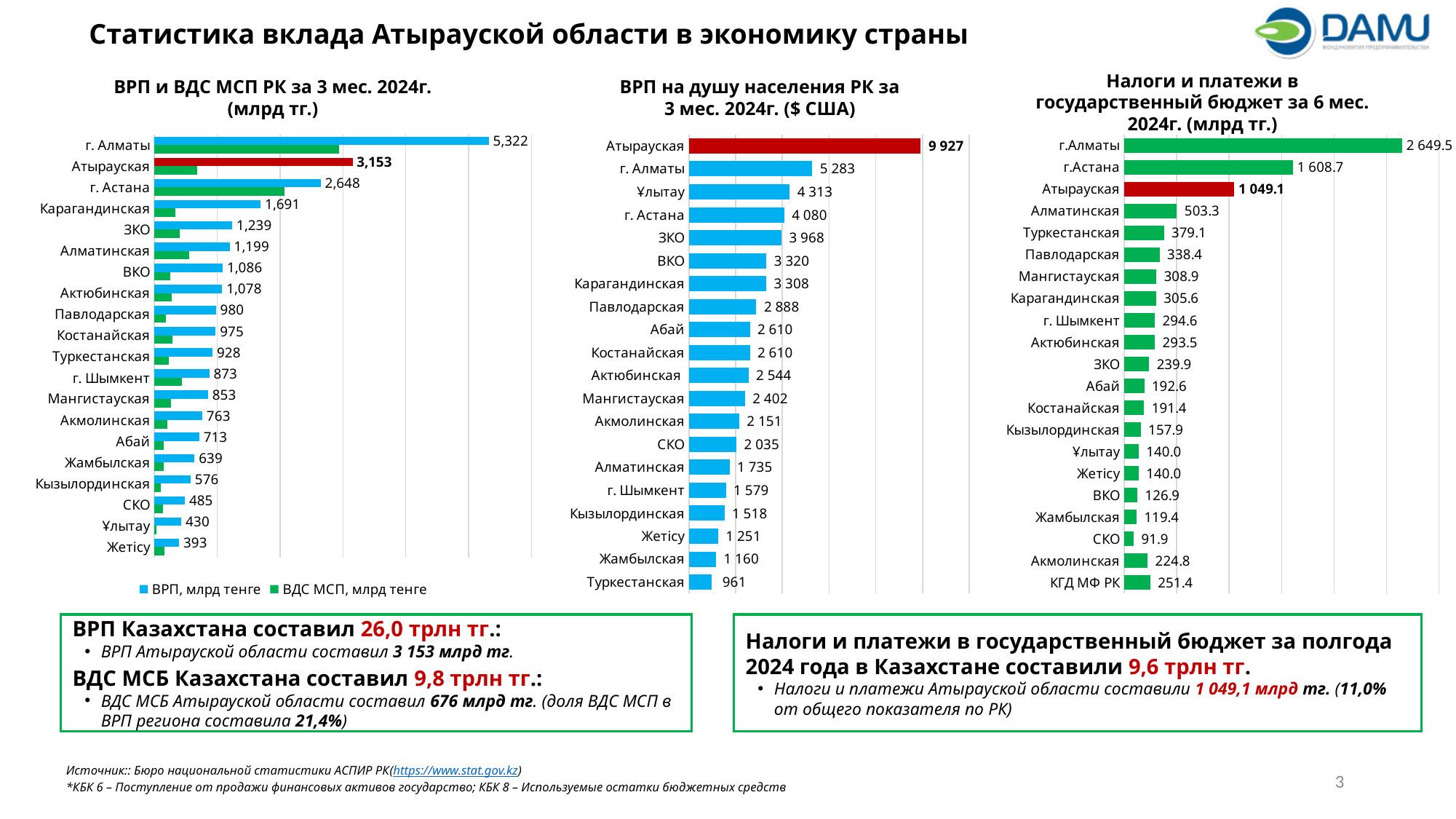
In the chart 'ВРП на душу населения РК за 3 мес. 2024г. ($ США)', what is the value for Ұлытау? 4 313 In the chart 'ВРП на душу населения РК за 3 мес. 2024г. ($ США)', how much higher is Атырауская than г. Алматы? 4 644 In the chart 'ВРП и ВДС МСП РК за 3 мес. 2024г. (млрд тг.)', which region has the highest ВРП? г. Алматы How many series does the legend of the chart 'ВРП и ВДС МСП РК за 3 мес. 2024г. (млрд тг.)' list? 2 In the chart 'ВРП и ВДС МСП РК за 3 мес. 2024г. (млрд тг.)', what is the ВРП value for Атырауская? 3,153 In the chart 'Налоги и платежи в государственный бюджет за 6 мес. 2024г. (млрд тг.)', which category has the lowest value? СКО What kind of chart is 'ВРП на душу населения РК за 3 мес. 2024г. ($ США)'? bar chart How many categories are shown in the chart 'Налоги и платежи в государственный бюджет за 6 мес. 2024г. (млрд тг.)'? 21 In the chart 'Налоги и платежи в государственный бюджет за 6 мес. 2024г. (млрд тг.)', which is larger: Павлодарская or Мангистауская? Павлодарская In the chart 'ВРП на душу населения РК за 3 мес. 2024г. ($ США)', which region has the lowest value? Туркестанская In the chart 'Налоги и платежи в государственный бюджет за 6 мес. 2024г. (млрд тг.)', what is the value for Атырауская? 1 049.1 In the chart 'ВРП и ВДС МСП РК за 3 мес. 2024г. (млрд тг.)', what is the difference between the ВРП of г. Алматы and г. Астана? 2,674